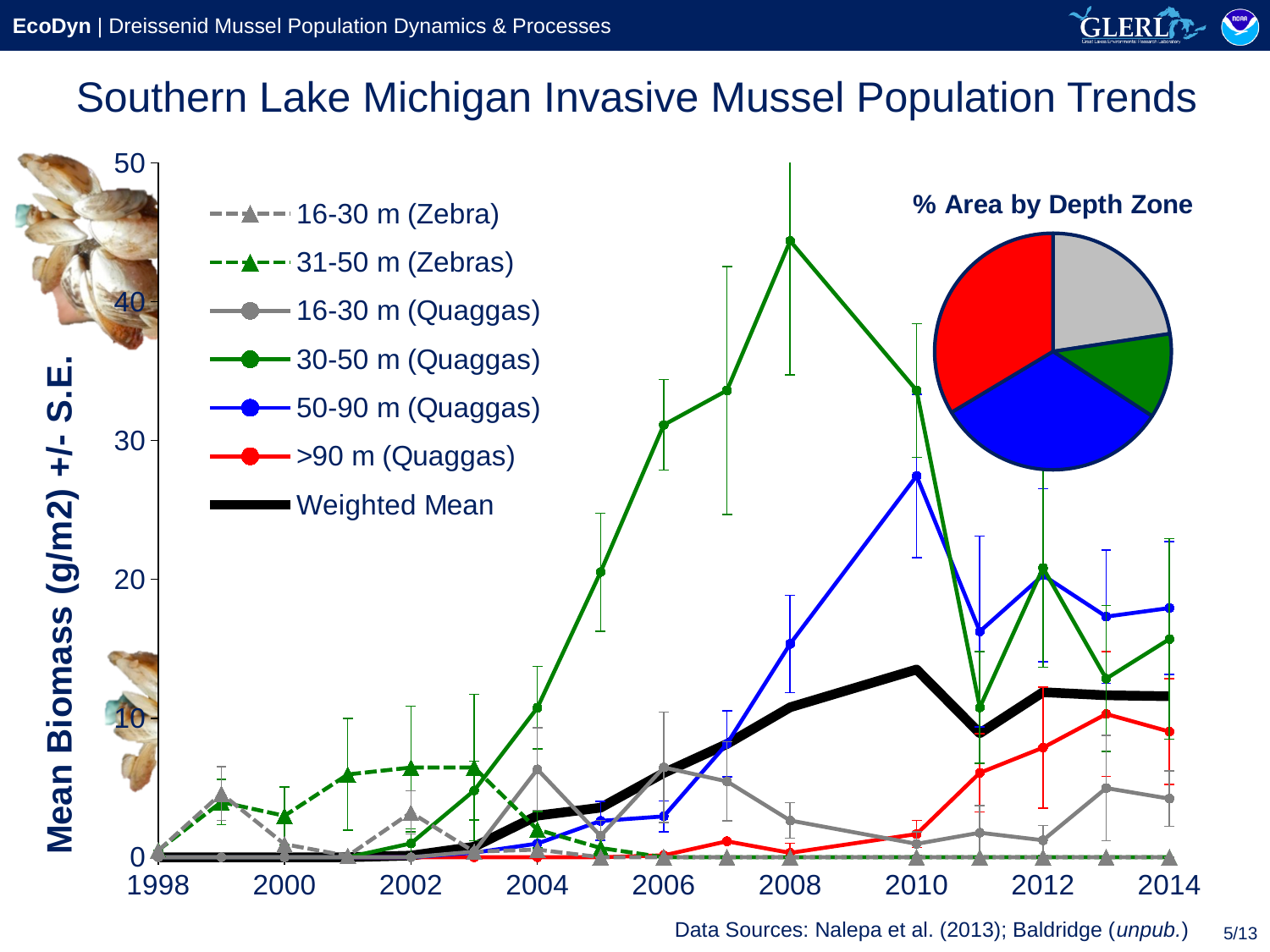
In the main line chart, which series has the higher value in 2010: 30-50 m (Quaggas) or 50-90 m (Quaggas)? 30-50 m (Quaggas) In the main line chart, in which year does the 30-50 m (Quaggas) series reach its highest value? 2008 In the main line chart, does the 30-50 m (Quaggas) series rise or fall between 2004 and 2008? Rise In the main line chart, is the value for >90 m (Quaggas) in 2012 greater or less than 10? less In the main line chart, is the value for 50-90 m (Quaggas) in 2010 greater or less than 20? greater What kind of chart is the main chart on the slide showing mean biomass over time? Line chart How many series does the legend of the main line chart list? 7 In the main line chart, is the value for 30-50 m (Quaggas) in 2008 greater or less than 40? greater In the main line chart, what is the value for 16-30 m (Zebra) in 2014? 0 How many slices does the '% Area by Depth Zone' pie chart have? 4